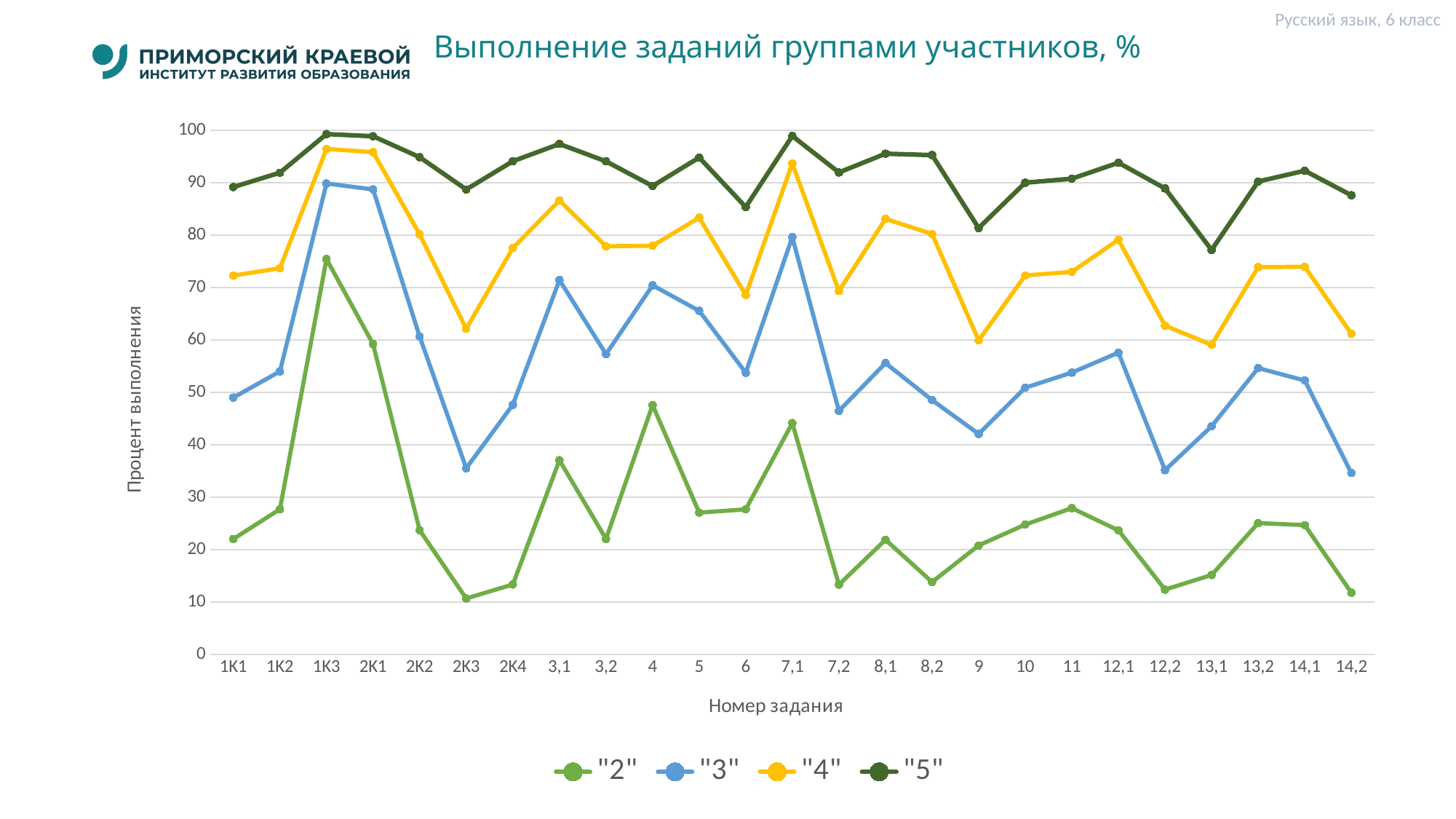
Is the value of the "3" series for task 2К3 greater or less than 40? less What is the label of the y axis? Процент выполнения How many task numbers (categories) are shown on the x axis? 25 What kind of chart is shown on the slide? line chart Is the value of the "2" series for task 1К3 greater or less than 70? greater For which task does the "5" series reach its lowest value? 13,1 Is the value of the "5" series for task 13,1 greater or less than 80? less Does the "5" series rise or fall from task 12,1 to task 13,1? fall How many series does the legend list? 4 For which task does the "2" series reach its highest value? 1К3 Which is larger for the "3" series: the value for task 3,1 or the value for task 3,2? 3,1